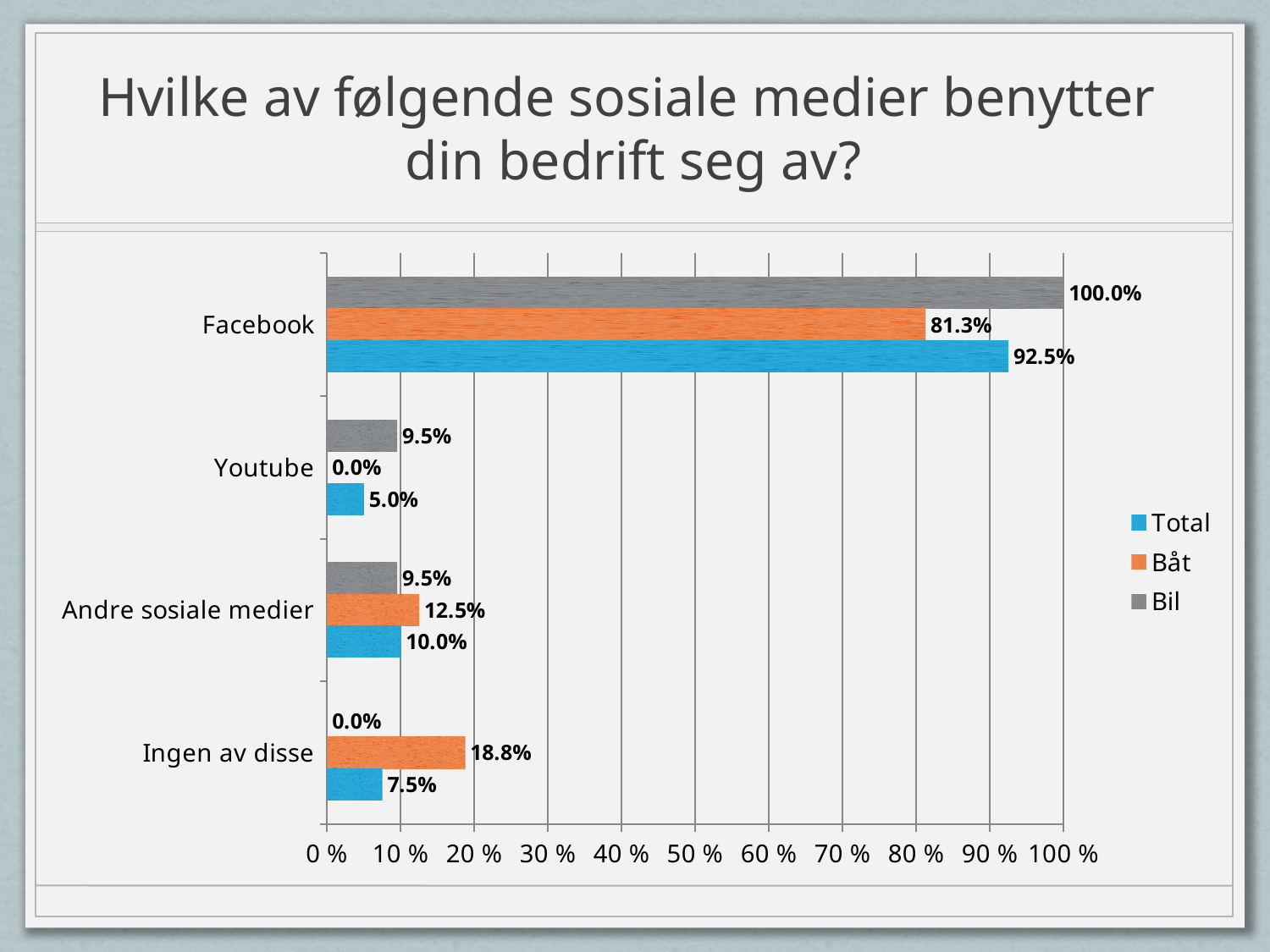
What is the difference between the Bil and Båt values for Facebook? 18.7% What is the Bil value for Youtube? 9.5% What is the title of the chart? Hvilke av følgende sosiale medier benytter din bedrift seg av? Which is larger for Andre sosiale medier: the Båt value or the Total value? Båt How many categories are shown on the chart? 4 Which series is shown in orange? Båt Which category has the highest Bil value? Facebook What kind of chart is shown on the slide? Bar chart How many series does the legend list? 3 Which category has the lowest Båt value? Youtube What is the Båt value for Ingen av disse? 18.8% What is the Total value for Facebook? 92.5%